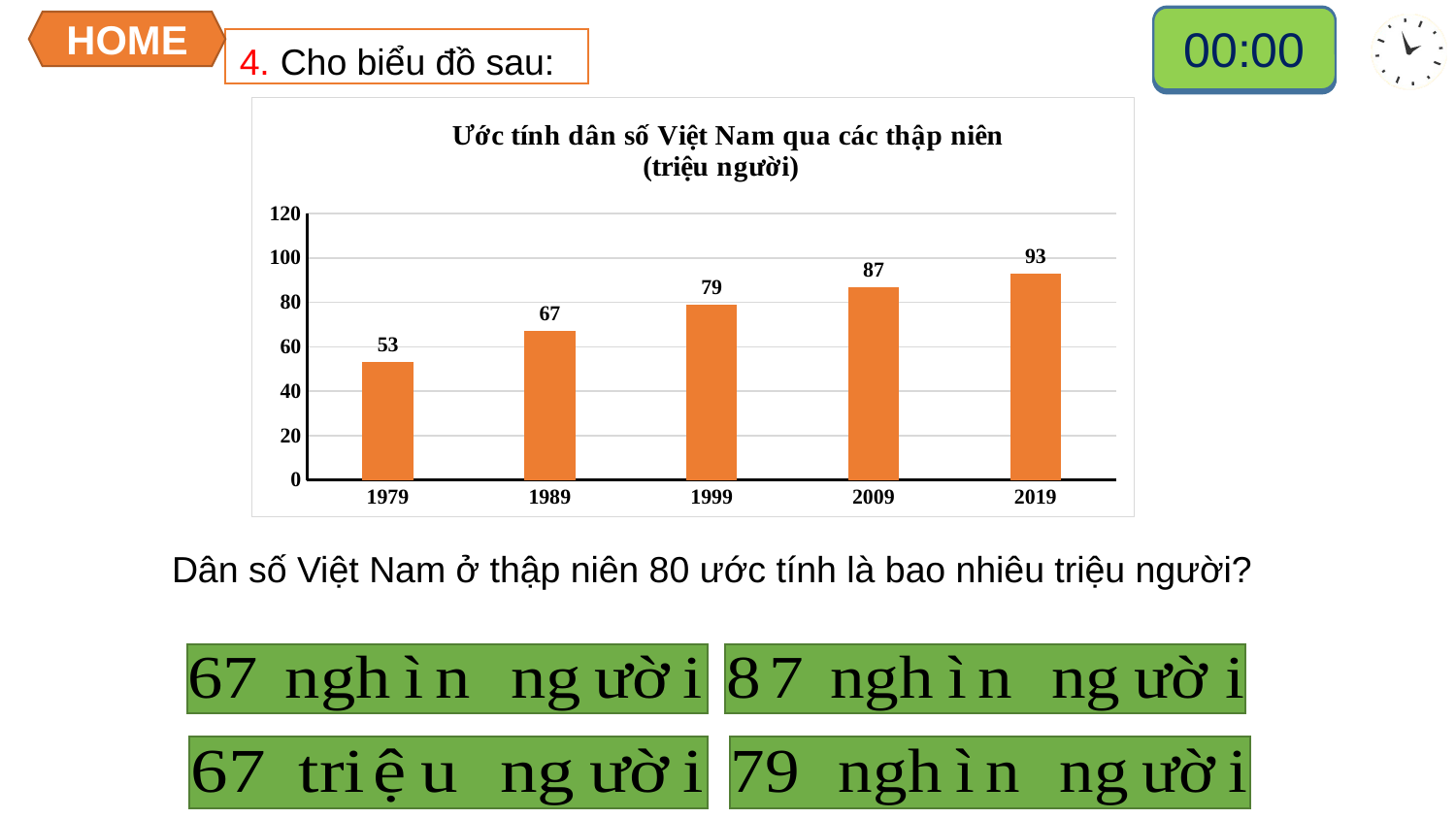
What kind of chart is shown on the slide? bar chart Is the value for 1999 greater or less than 60? greater What is the value shown for 2019? 93 Which is larger, the value for 1989 or the value for 2009? 2009 What is the difference between the values for 2009 and 1999? 8 Which year has the lowest value on the chart? 1979 Which year has the highest value on the chart? 2019 What is the difference between the values for 2019 and 1979? 40 What is the estimated population of Vietnam in 1979 according to the chart? 53 Do the values rise or fall from 1979 to 2019? rise What value does the chart show for 1989? 67 How many years are shown on the x axis of the chart? 5